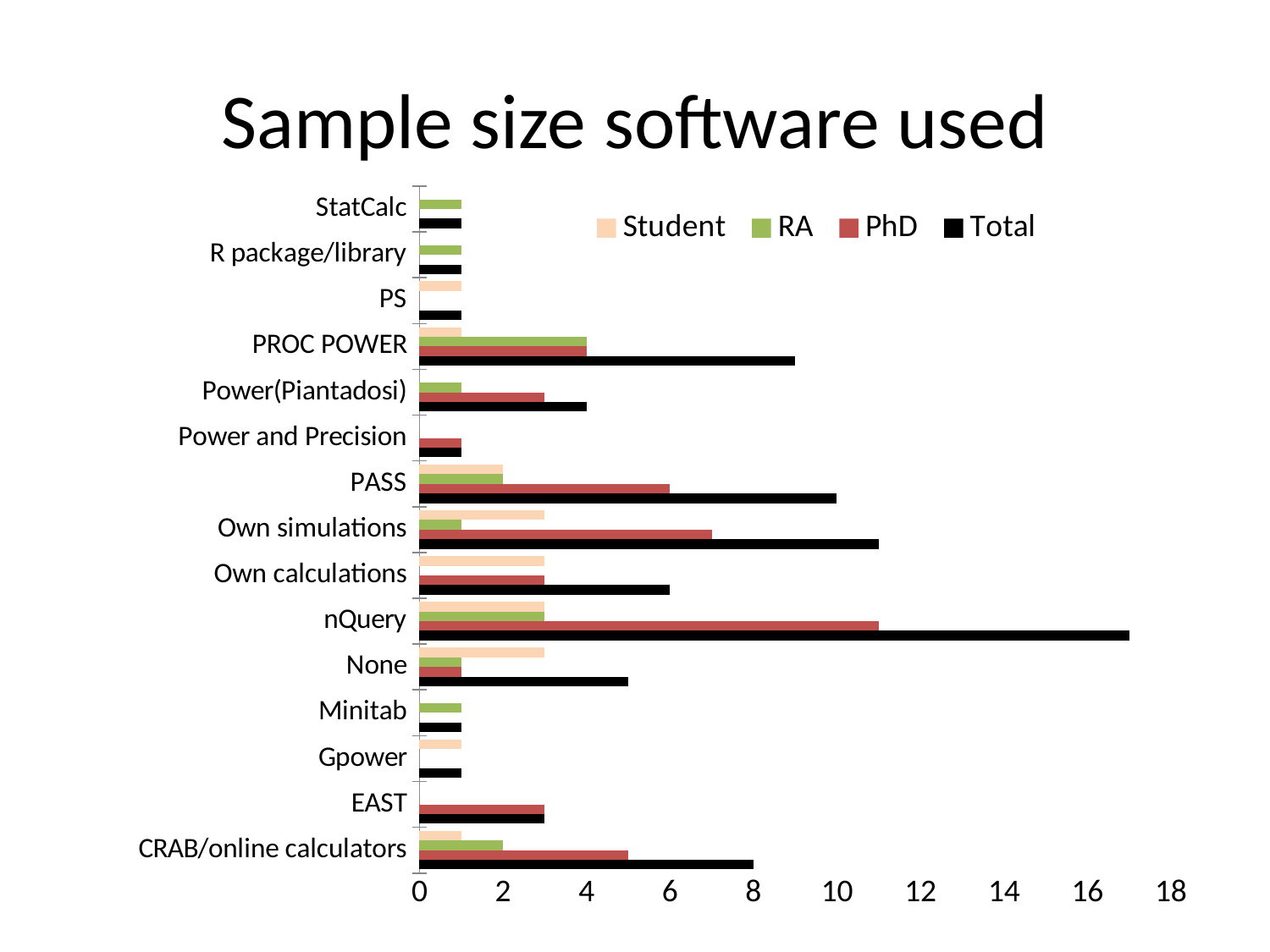
Is the Total value for nQuery greater or less than 16? greater Is the Total value for Own simulations greater or less than 10? greater Which is larger, the Total value for nQuery or the Total value for PASS? nQuery What type of chart is shown on the slide? bar chart Which category has the highest Total value? nQuery What is the Total value for PASS? 10 What is the Total value for CRAB/online calculators? 8 What is the difference between the Total value for PASS and the Total value for CRAB/online calculators? 2 How many series does the legend list? 4 What is the RA value for PROC POWER? 4 What is the title of the chart? Sample size software used How many software categories are shown on the chart? 15